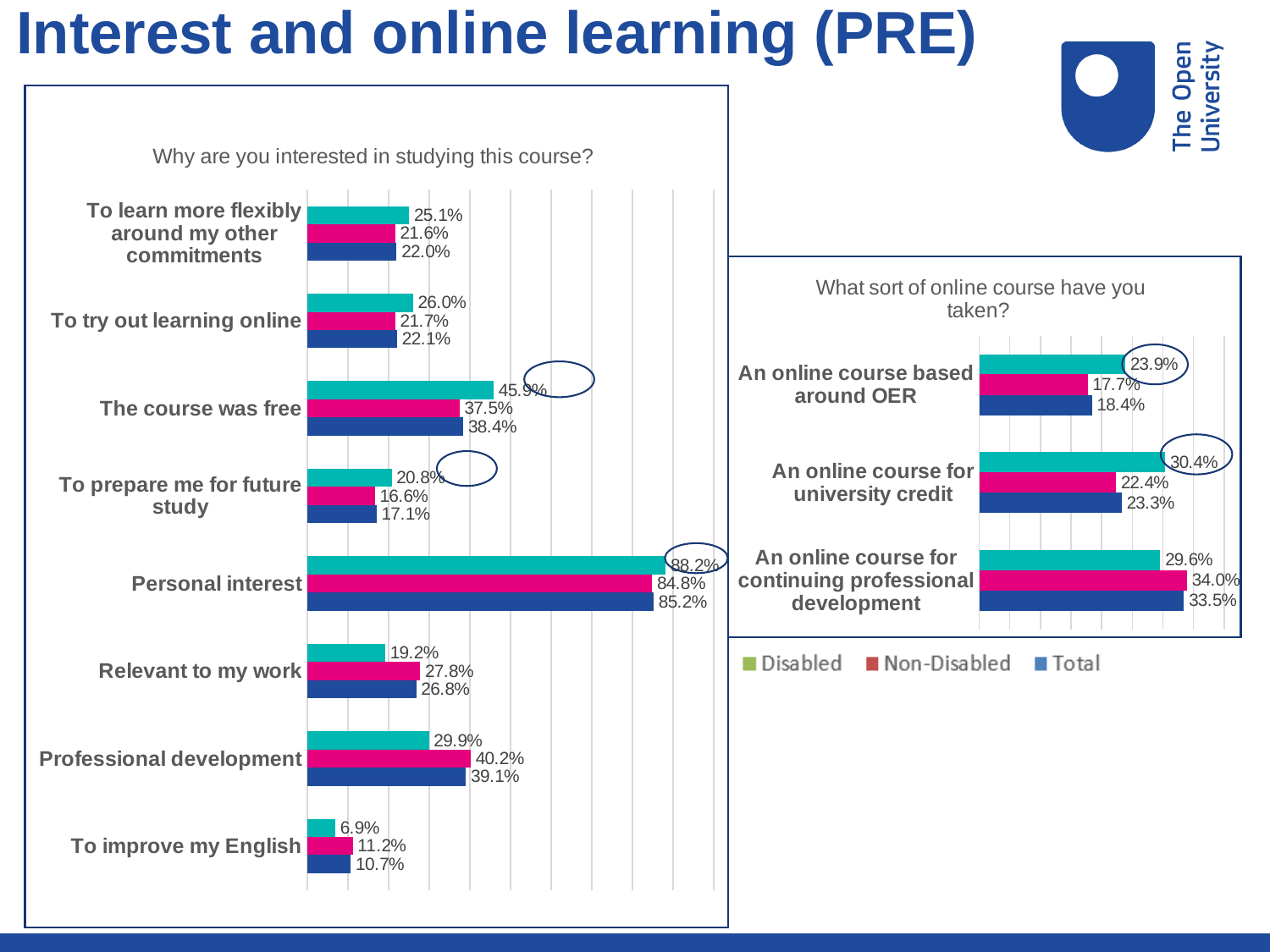
In the chart 'Why are you interested in studying this course?', which reason has the highest values across all series? Personal interest In the chart 'What sort of online course have you taken?', what is the Non-Disabled value for 'An online course for continuing professional development'? 34.0% In the chart 'What sort of online course have you taken?', what is the Total value for 'An online course for university credit'? 23.3% How many reasons (categories) are shown in the chart 'Why are you interested in studying this course?'? 8 In the chart 'Why are you interested in studying this course?', which reason has the lowest Total value? To improve my English In the chart 'What sort of online course have you taken?', which has the larger Total value: 'An online course for university credit' or 'An online course for continuing professional development'? An online course for continuing professional development In the chart 'Why are you interested in studying this course?', what is the difference between the Non-Disabled and Disabled values for 'Relevant to my work'? 8.6 percentage points How many series does the legend list for the charts on this slide? 3 In the chart 'Why are you interested in studying this course?', what is the Total value for 'The course was free'? 38.4% In the chart 'Why are you interested in studying this course?', what is the Non-Disabled value for 'Professional development'? 40.2% What type of chart is 'What sort of online course have you taken?'? Bar chart In the chart 'Why are you interested in studying this course?', what is the Disabled value for 'To try out learning online'? 26.0%